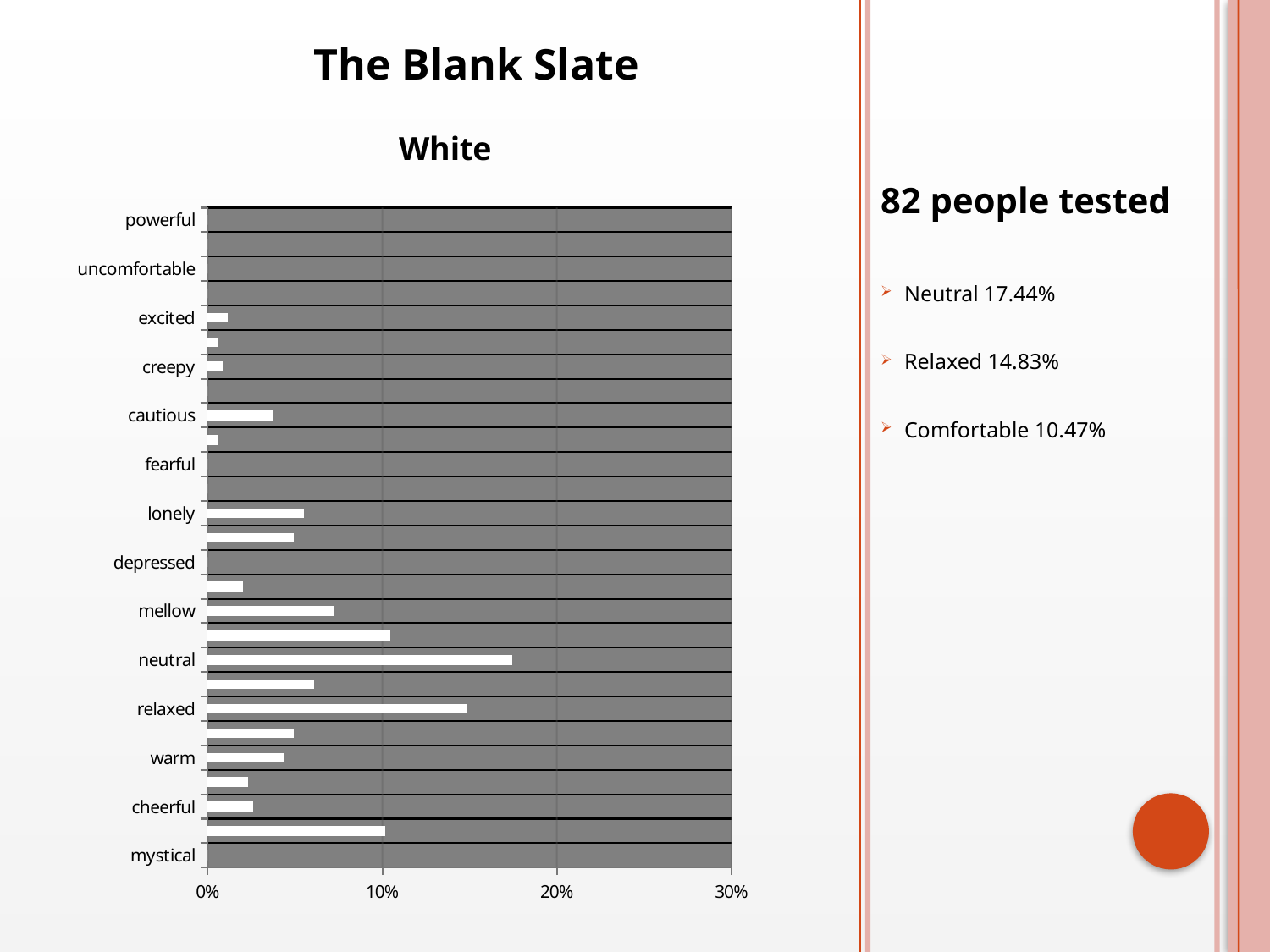
What is the highest value shown on the chart's horizontal axis? 30% According to the slide, what percentage of people tested chose neutral for white? 17.44% Is the value for cheerful greater or less than 10%? less Which has the larger value, neutral or relaxed? neutral Is the value for cautious greater or less than 10%? less Is the value for mellow greater or less than 10%? less Which has the larger value, mellow or cautious? mellow What kind of chart is shown on the slide? bar chart Which labelled category has the longest bar in the chart? neutral What is the title of the chart? White